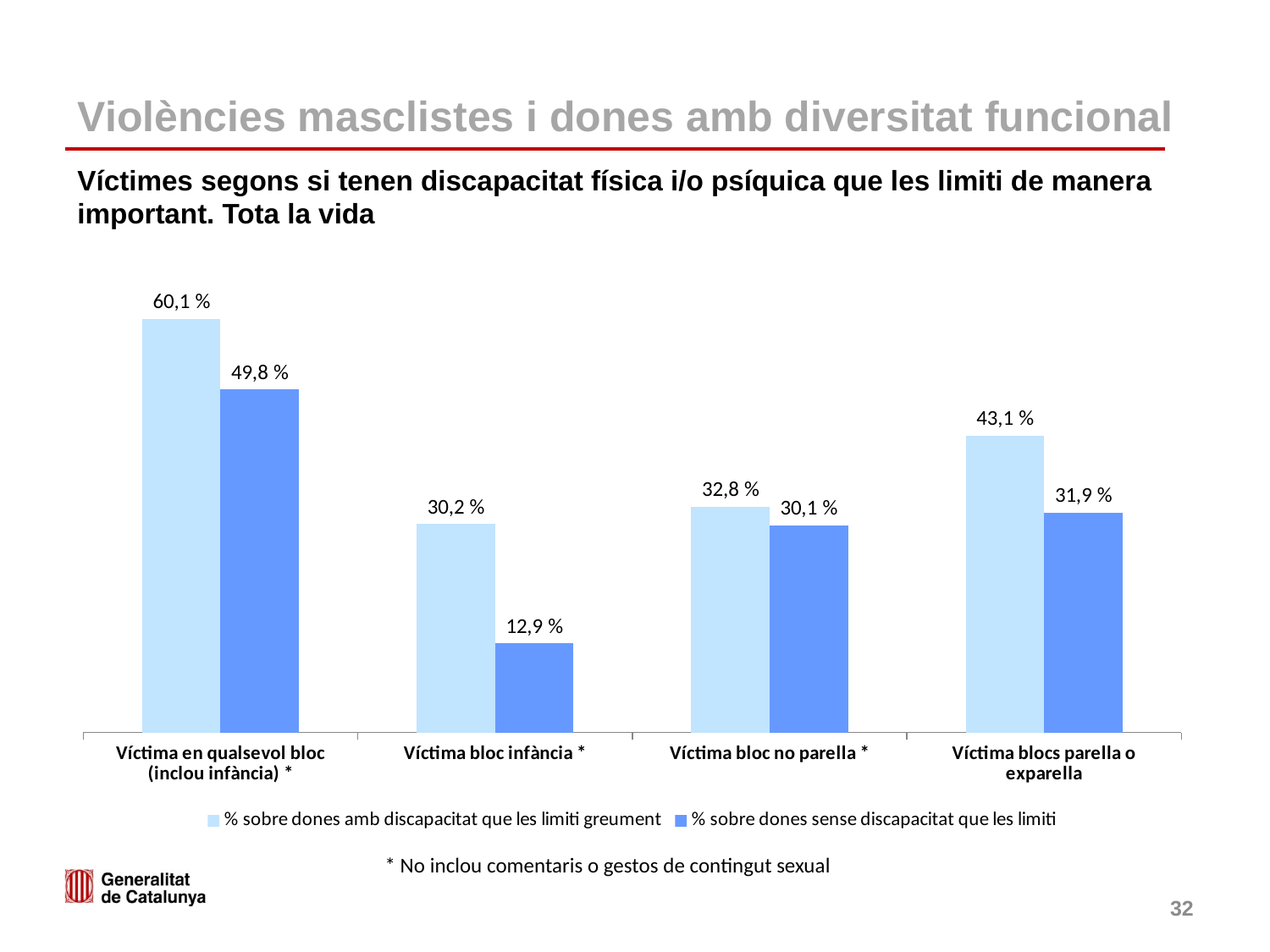
What is the value for 'Víctima bloc no parella *' in the series '% sobre dones sense discapacitat que les limiti'? 30,1 % What is the value for 'Víctima blocs parella o exparella' in the series '% sobre dones amb discapacitat que les limiti greument'? 43,1 % How many series does the legend list? 2 What kind of chart is shown on the slide? Bar chart How many categories are shown on the x axis? 4 What does the asterisk footnote below the chart say? * No inclou comentaris o gestos de contingut sexual Which category has the highest value in the series '% sobre dones amb discapacitat que les limiti greument'? Víctima en qualsevol bloc (inclou infància) * Which category has the lowest value in the series '% sobre dones sense discapacitat que les limiti'? Víctima bloc infància * What is the difference between the two series for 'Víctima bloc infància *'? 17,3 % What is the value for 'Víctima bloc infància *' in the series '% sobre dones sense discapacitat que les limiti'? 12,9 % For 'Víctima blocs parella o exparella', which series has the larger value? % sobre dones amb discapacitat que les limiti greument What is the difference between the two series for 'Víctima en qualsevol bloc (inclou infància) *'? 10,3 %